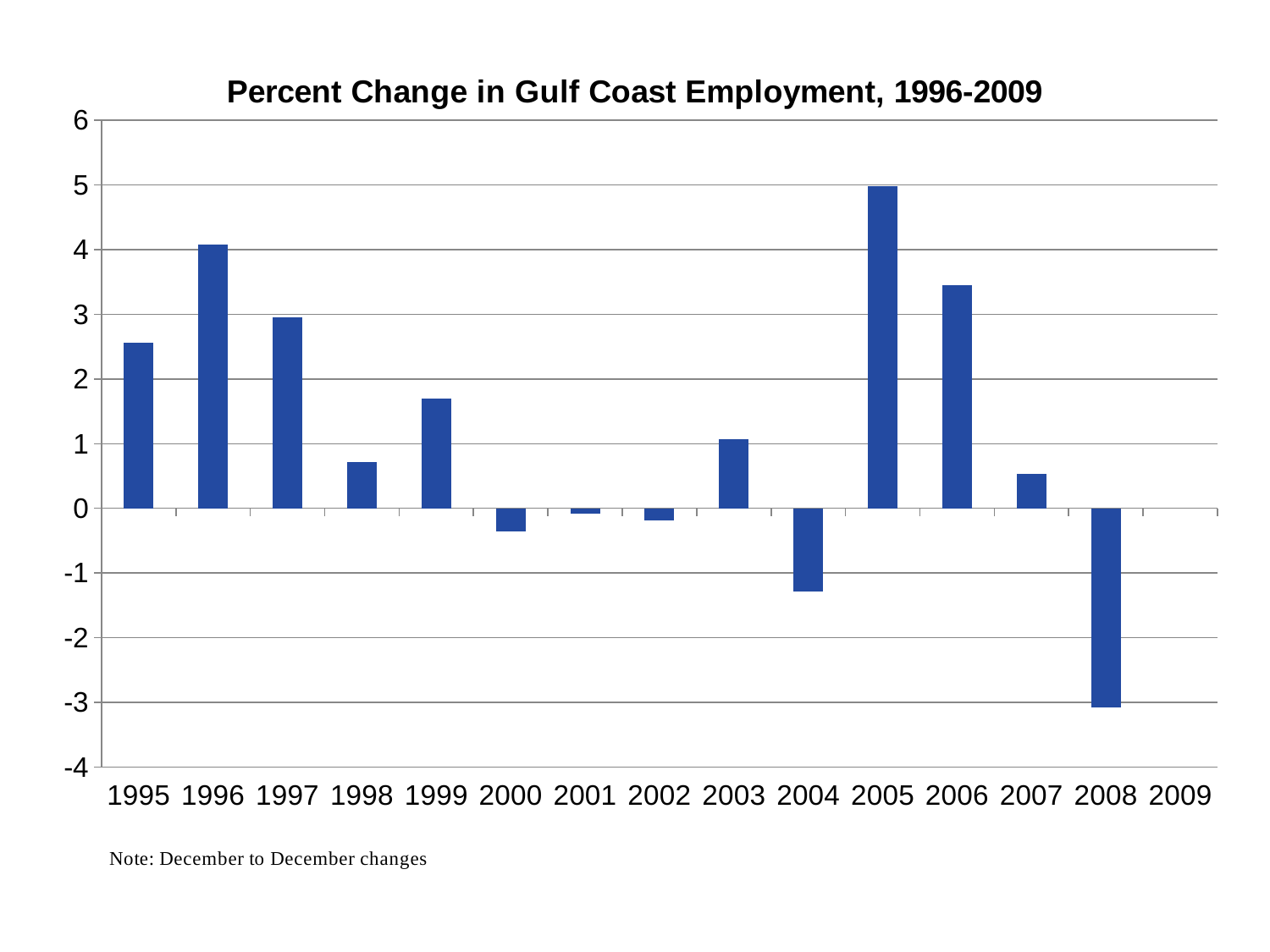
What kind of chart is shown on the slide? bar chart How many year labels are shown on the x axis? 15 Is the value for 2004 greater or less than -1? less Is the value for 2008 greater or less than -2? less Is the value for 2005 greater or less than 4? greater Which year has the larger percent change, 1996 or 2005? 2005 Which year has the lowest percent change in Gulf Coast employment? 2008 Which year has the larger percent change, 1999 or 2003? 1999 Which year has the highest percent change in Gulf Coast employment? 2005 Do the values rise or fall from 1996 to 1998? fall What is the title of the chart? Percent Change in Gulf Coast Employment, 1996-2009